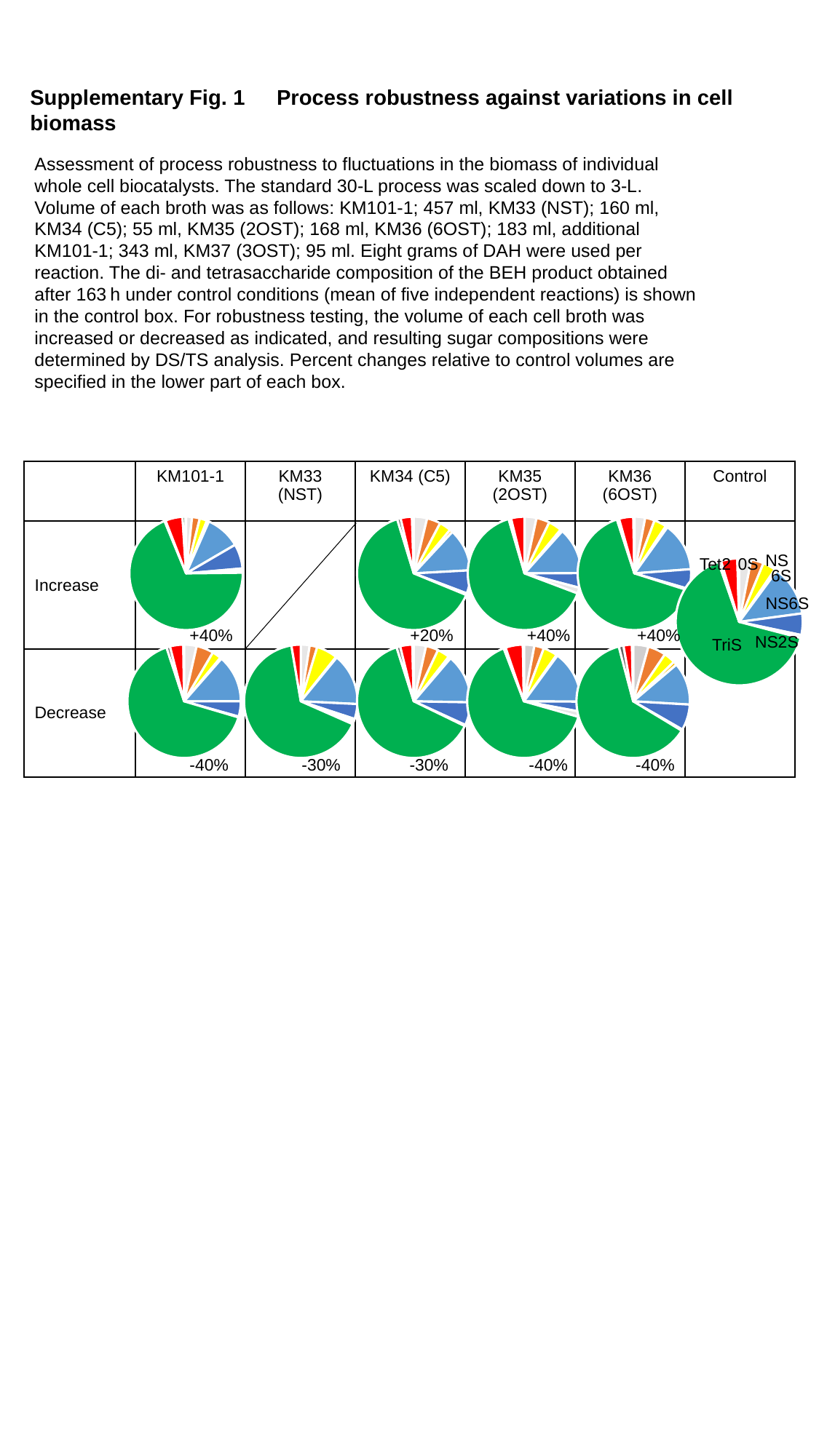
In the Control pie chart, does the TriS slice take up more or less than half of the pie? more In the KM35 (2OST) Increase pie chart, is the green slice larger or smaller than the light blue slice? larger How many slices are labelled in the Control pie chart? 7 What percent change is printed under the KM101-1 Decrease pie chart? -40% What kind of chart is used in each cell of the table? pie chart What percent change is printed under the KM34 (C5) Increase pie chart? +20% In the Control pie chart, is the TriS slice larger or smaller than the NS6S slice? larger How many pie charts are shown in the Decrease row? 5 In the Control pie chart, which slice is labelled NS2S, the dark blue one or the green one? the dark blue one In the Control pie chart, which slice is the largest? TriS What percent change is printed under the KM33 (NST) Decrease pie chart? -30% Which cell of the table contains no pie chart? KM33 (NST) Increase